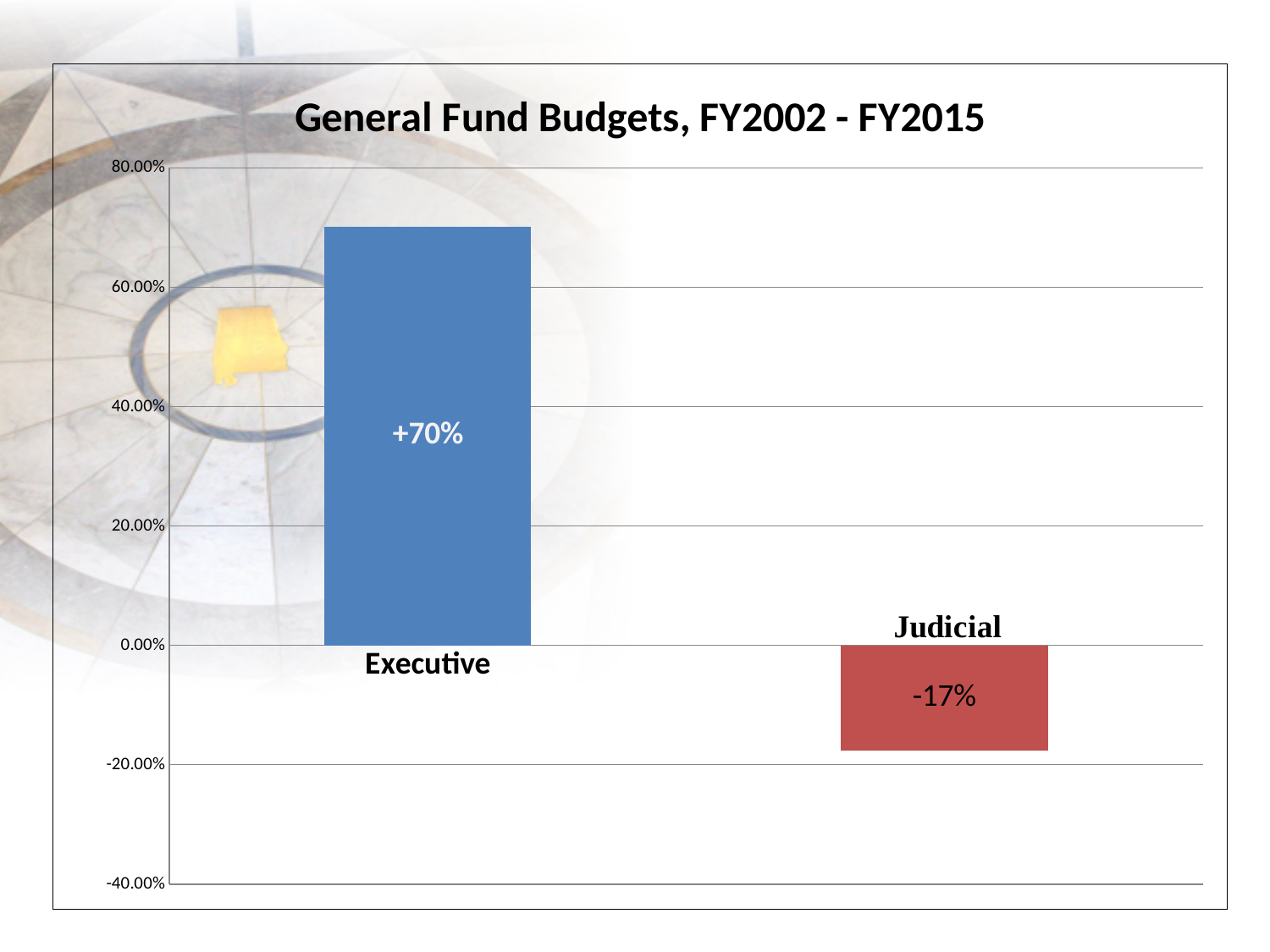
What kind of chart is shown on the slide? bar chart What is the value shown for Executive? +70% Which category has the lowest value? Judicial What is the title of the chart? General Fund Budgets, FY2002 - FY2015 What is the value shown for Judicial? -17% How many categories are plotted in the chart? 2 Which category has the highest value? Executive Is the value for Judicial greater or less than 0.00%? less Which is larger, the value for Executive or the value for Judicial? Executive Is the value for Executive greater or less than 60.00%? greater What is the lowest value shown on the vertical axis? -40.00% What colour is the bar for Judicial? red